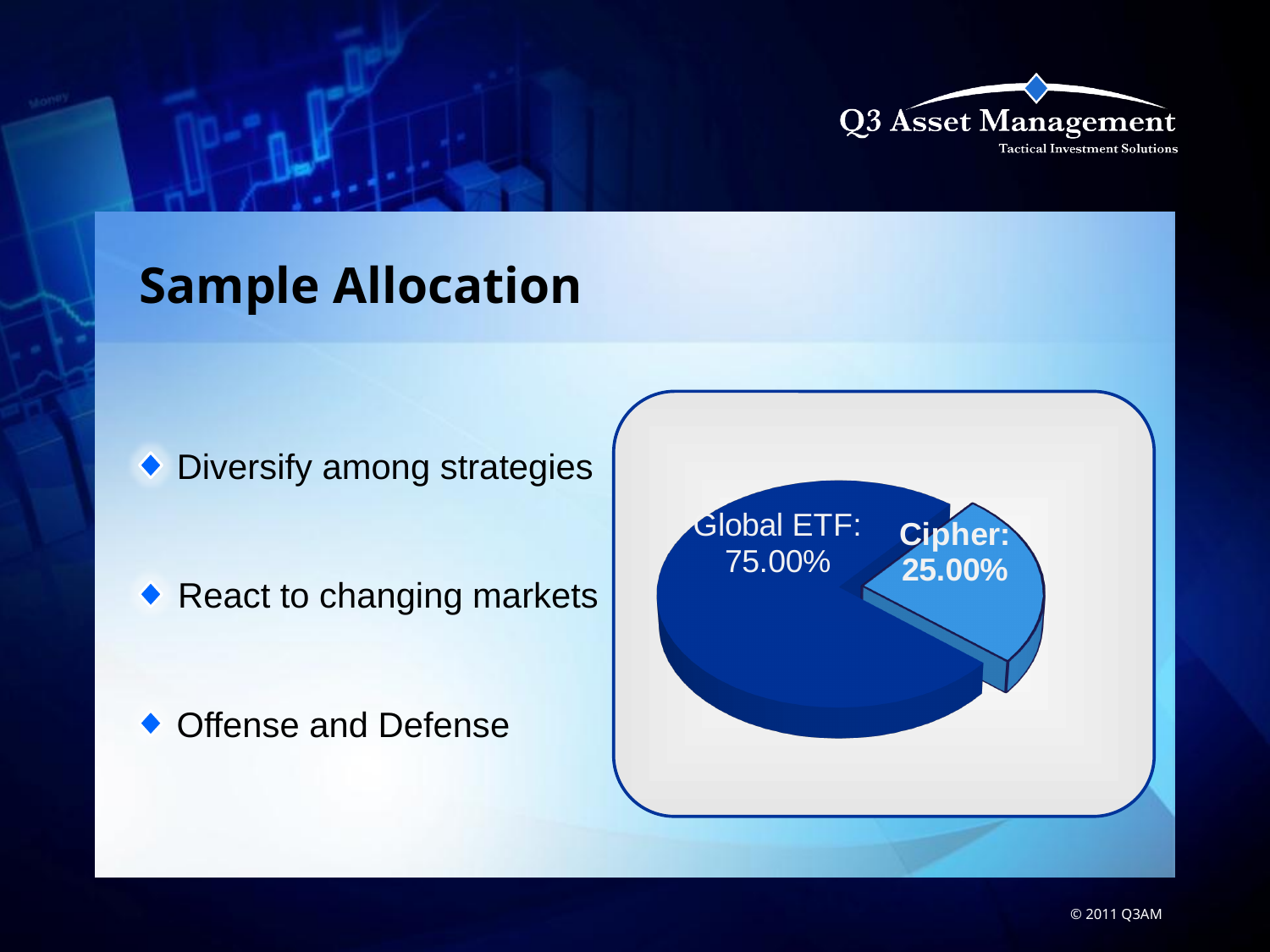
Is the Cipher share greater or less than 50%? less What share of the pie does Cipher represent? 25.00% How many slices does the pie chart have? 2 What is the title of the slide containing the pie chart? Sample Allocation What kind of chart is shown on the slide? Pie chart Which slice of the pie is the largest? Global ETF Which is larger, the Global ETF slice or the Cipher slice? Global ETF Which slice of the pie is the smallest? Cipher What is the difference in percentage points between the Global ETF and Cipher slices? 50.00% What share of the pie does Global ETF represent? 75.00% Which slice of the pie is pulled out (exploded) from the rest? Cipher